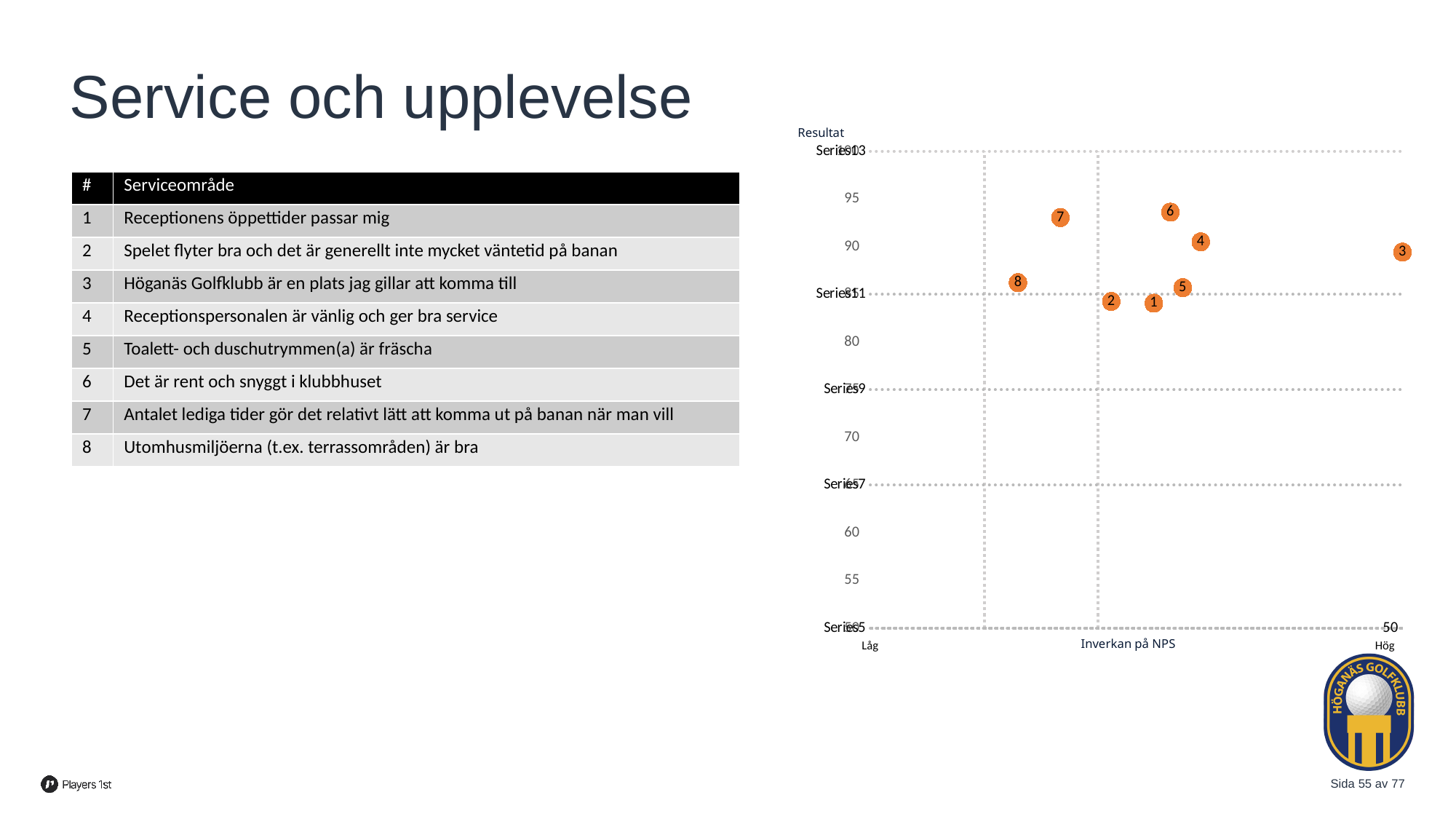
Is the Resultat value for point 2 greater or less than 90? less Which point has the lowest Inverkan på NPS (is furthest to the left)? 8 Is the Resultat value for point 6 greater or less than 90? greater How many numbered points are plotted on the chart? 8 Which has a higher Resultat value, point 7 or point 1? point 7 What kind of chart is shown on the slide? scatter chart Which point has the highest Inverkan på NPS (is furthest to the right)? 3 Is the Resultat value for point 1 greater or less than 85? less What is the label of the horizontal axis of the chart? Inverkan på NPS What is the label of the vertical axis of the chart? Resultat